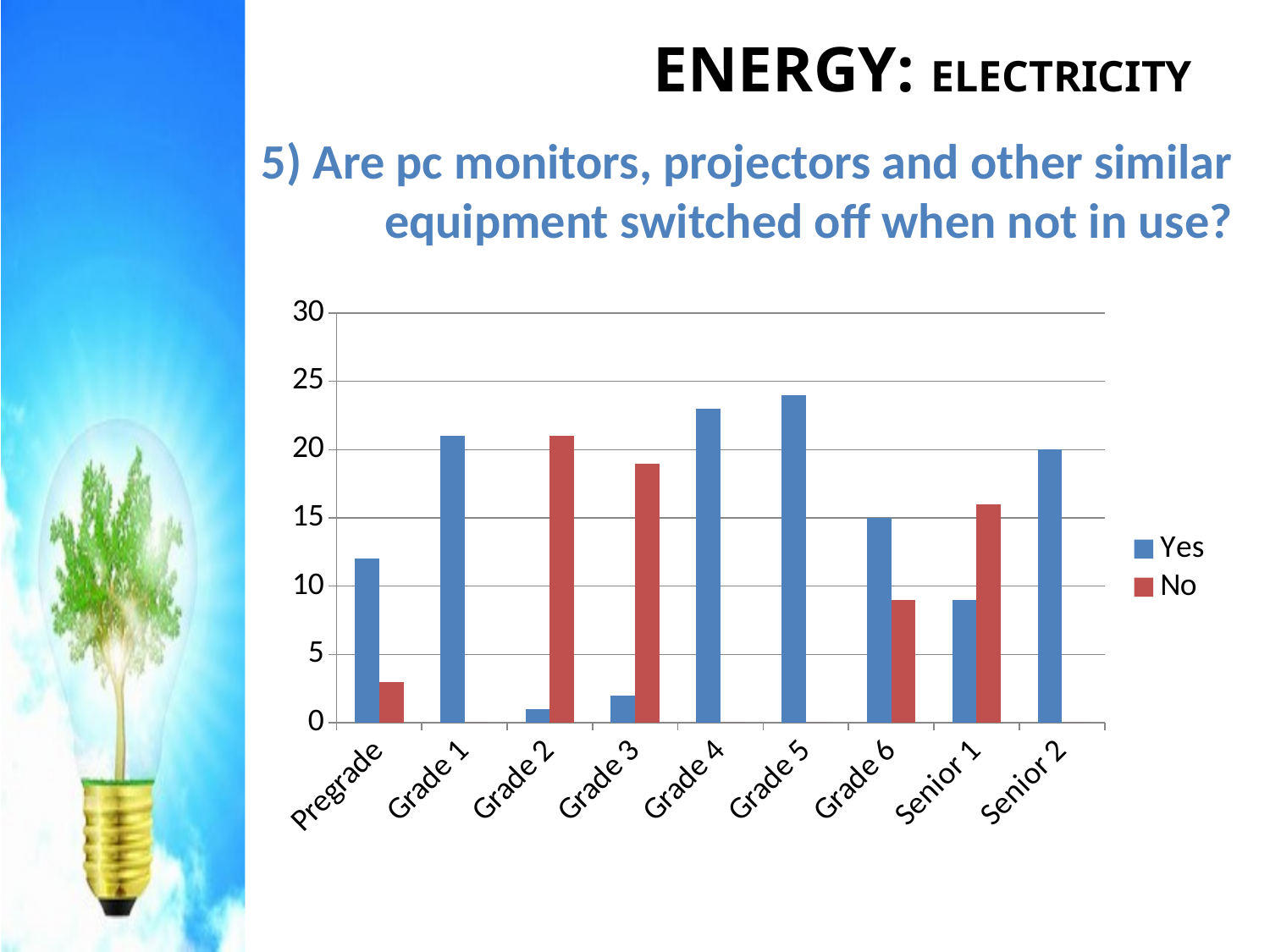
Which is larger, the Yes value for Grade 1 or the Yes value for Grade 6? Grade 1 Which is larger for Grade 3, the Yes value or the No value? No How many series does the legend list? 2 Is the Yes value for Grade 4 greater or less than 20? greater What colour are the bars for the No series? red What kind of chart is shown on the slide? bar chart Which category has the highest Yes value? Grade 5 Which category has the highest No value? Grade 2 Is the No value for Pregrade greater or less than 5? less Which category has the lowest Yes value? Grade 2 How many grade categories are shown on the x axis? 9 Is the No value for Senior 1 greater or less than 15? greater